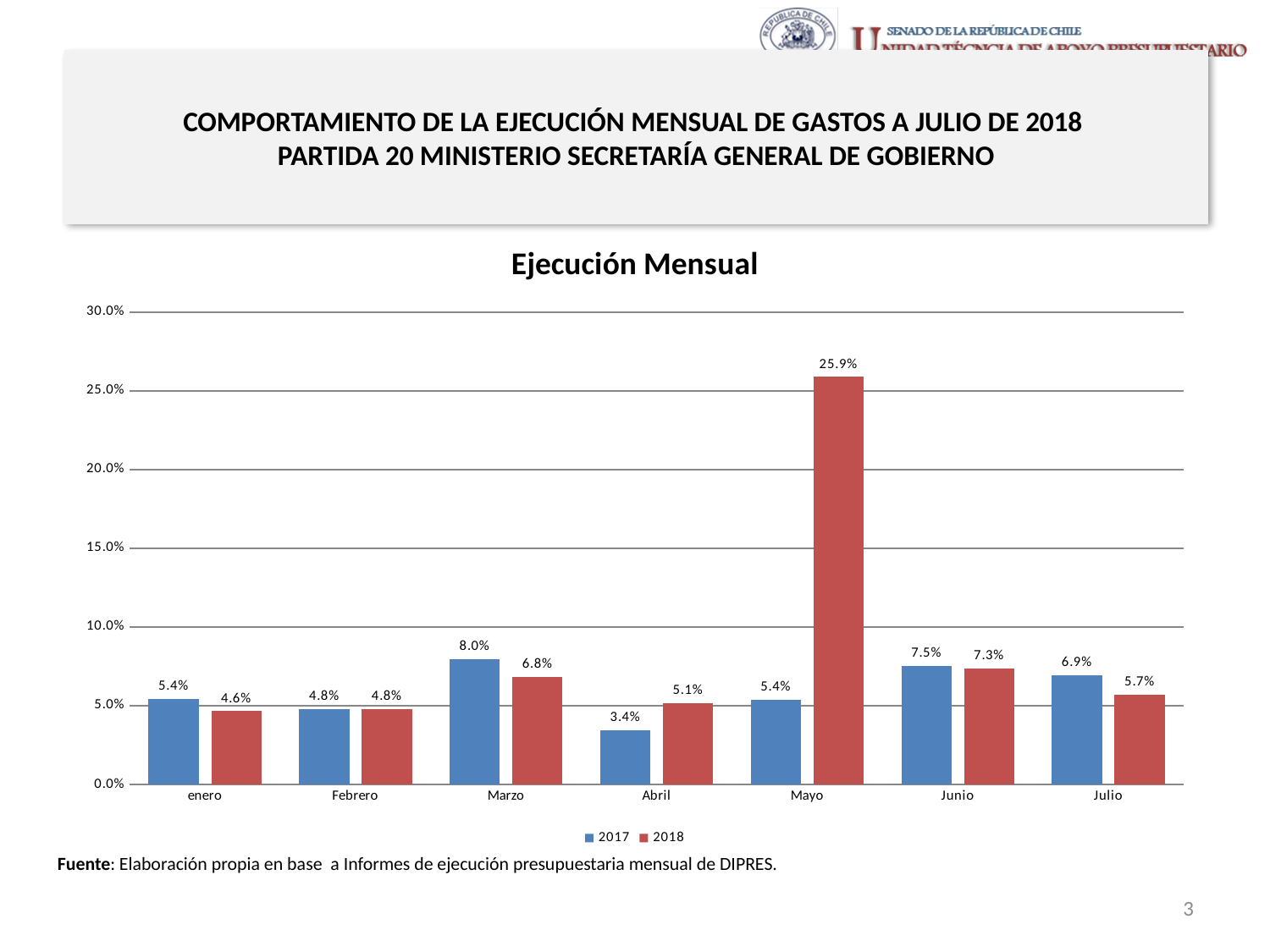
Which month has the highest value for the 2018 series? Mayo What is the value for 2018 in Julio? 5.7% Which is larger in Marzo, the 2017 value or the 2018 value? 2017 Is the value for 2018 in Mayo greater or less than 25.0%? greater What kind of chart is shown? Bar chart What is the value for 2017 in Abril? 3.4% What is the difference between the 2018 and 2017 values in Mayo? 20.5% What is the value for 2017 in Marzo? 8.0% Which month has the lowest value for the 2017 series? Abril What is the value for 2018 in Mayo? 25.9% How many months are shown on the x axis? 7 How many series does the legend list? 2